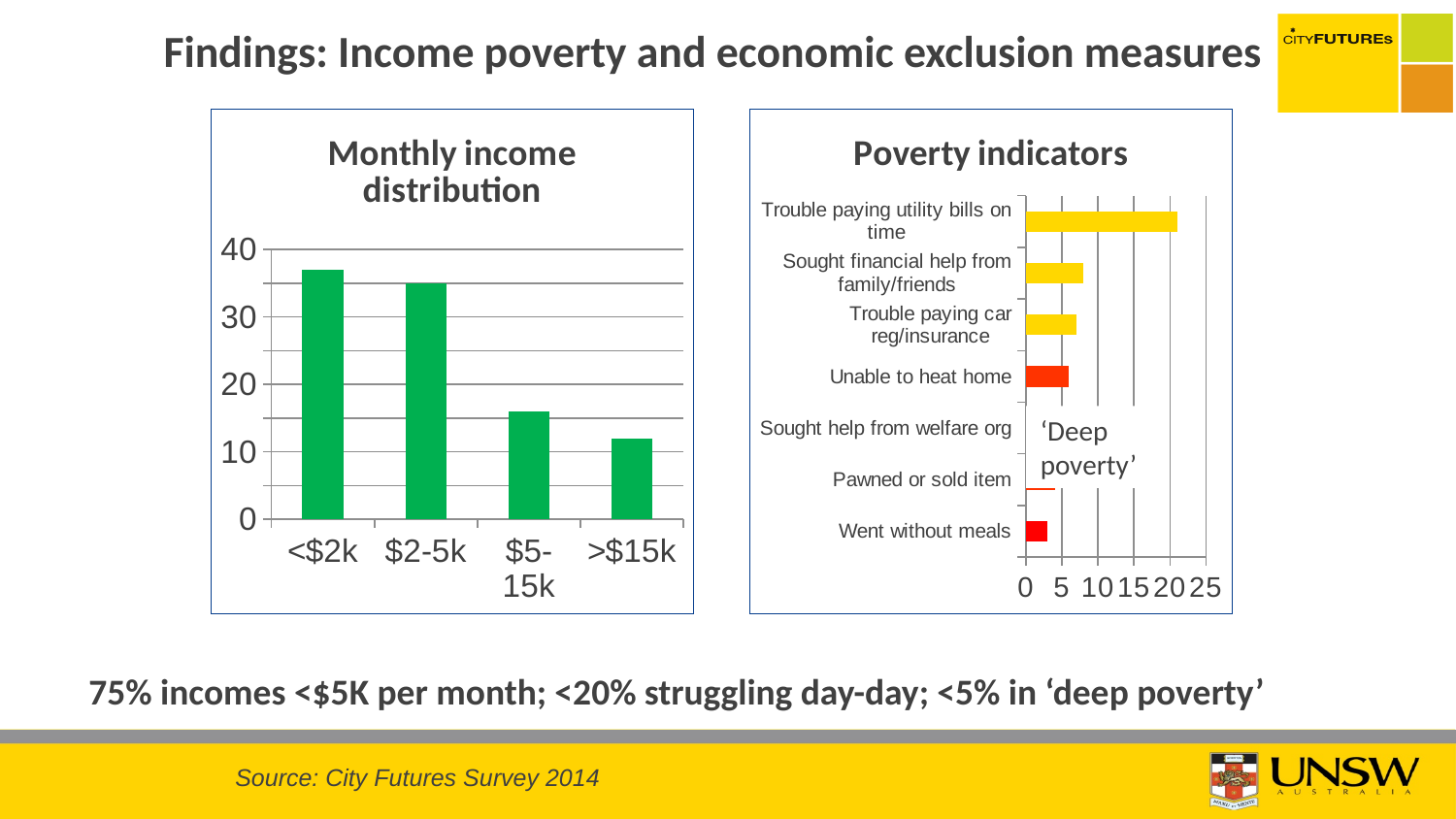
On the 'Monthly income distribution' chart, do the values rise or fall moving from <$2k to >$15k? fall On the 'Monthly income distribution' chart, which income category has the highest value? <$2k On the 'Poverty indicators' chart, which indicator has the highest value? Trouble paying utility bills on time How many income categories are shown on the 'Monthly income distribution' chart? 4 How many poverty indicators are listed on the 'Poverty indicators' chart? 7 What kind of chart is the 'Monthly income distribution' chart? bar chart On the 'Monthly income distribution' chart, is the value for $5-15k greater or less than 20? less On the 'Monthly income distribution' chart, which income category has the lowest value? >$15k On the 'Monthly income distribution' chart, is the value for $2-5k greater or less than 30? greater On the 'Poverty indicators' chart, which is larger: 'Sought financial help from family/friends' or 'Went without meals'? Sought financial help from family/friends What kind of chart is the 'Poverty indicators' chart? bar chart